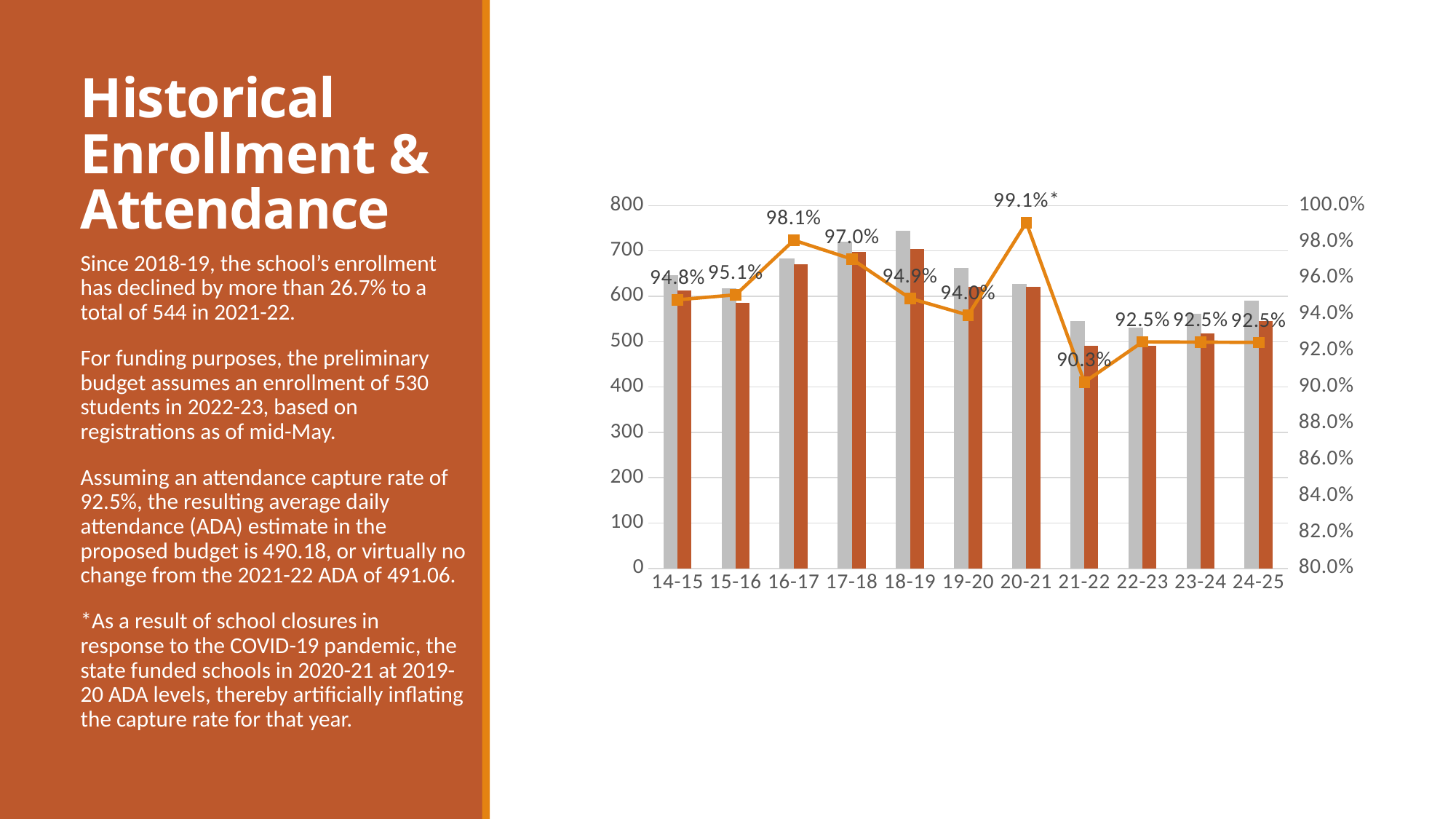
What is the attendance capture rate shown for 16-17? 98.1% What is the difference between the percentage for 16-17 and the percentage for 21-22? 7.8 percentage points Which school year has the lowest percentage on the line? 21-22 Which school year has the highest percentage on the line? 20-21 How many school years are shown on the x axis? 11 What is the percentage value labelled on the line for 21-22? 90.3% Which year has a higher percentage on the line, 16-17 or 17-18? 16-17 Is the gray bar for 18-19 greater or less than 700? greater What kind of chart is shown on the slide? Combination bar and line chart What percentage is shown for 20-21 on the line? 99.1%* Is the orange bar for 19-20 greater or less than 600? greater Does the percentage line rise or fall from 16-17 to 19-20? Falls